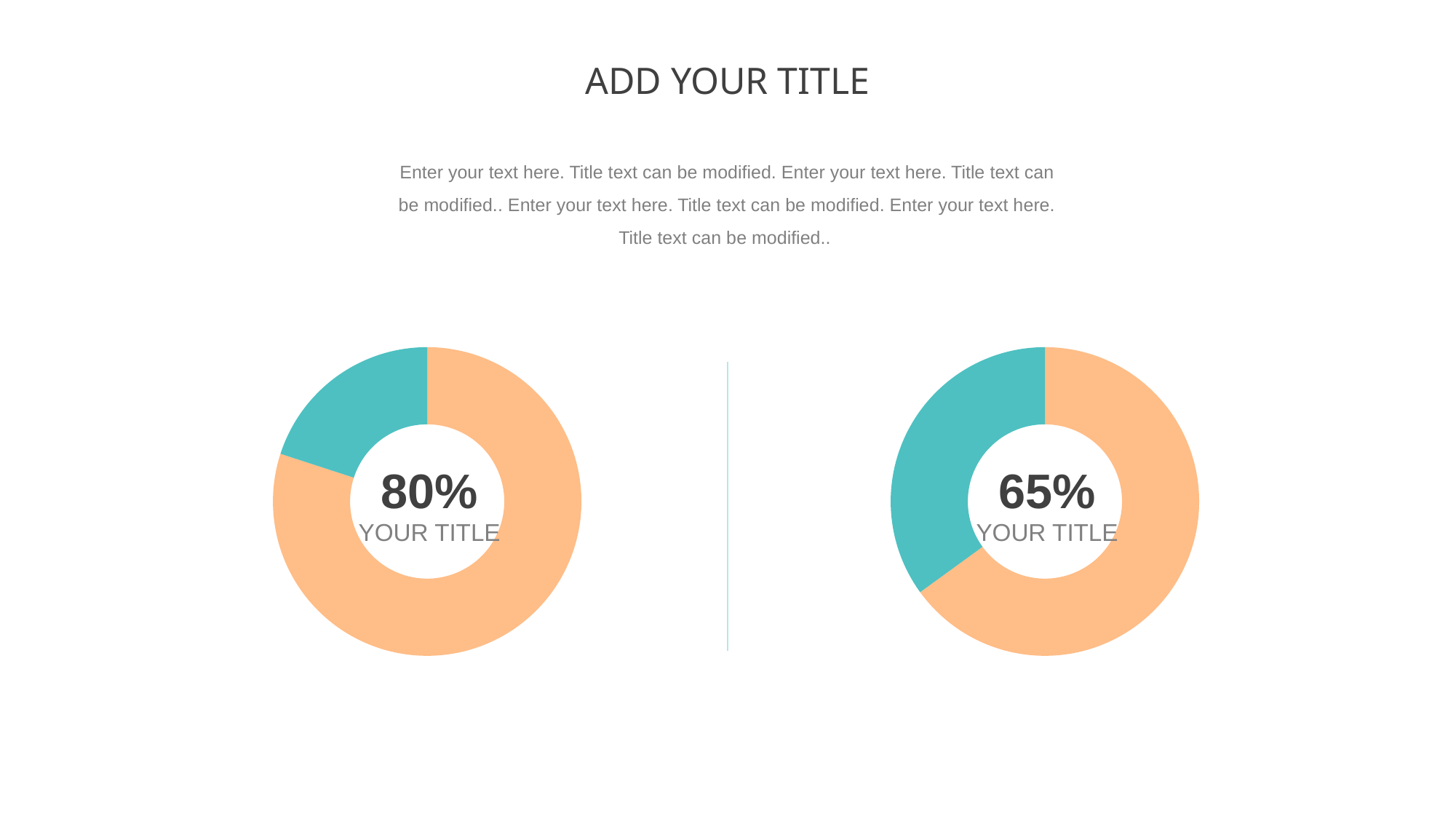
What percentage is shown in the centre of the right donut chart? 65% What label appears beneath the percentage in the left donut chart? YOUR TITLE What kind of chart is used on the left side of the slide? Donut (pie) chart In the left donut chart, which colour fills the larger portion of the ring? Orange Which chart shows the higher percentage, the left one or the right one? The left one How many donut charts are on the slide? 2 In the right donut chart, which colour fills the smaller portion of the ring? Teal What percentage is shown in the centre of the left donut chart? 80% What is the difference between the percentage in the left chart and the percentage in the right chart? 15 percentage points Is the percentage shown in the right donut chart greater or less than 50%? greater What is the title at the top of the slide? ADD YOUR TITLE